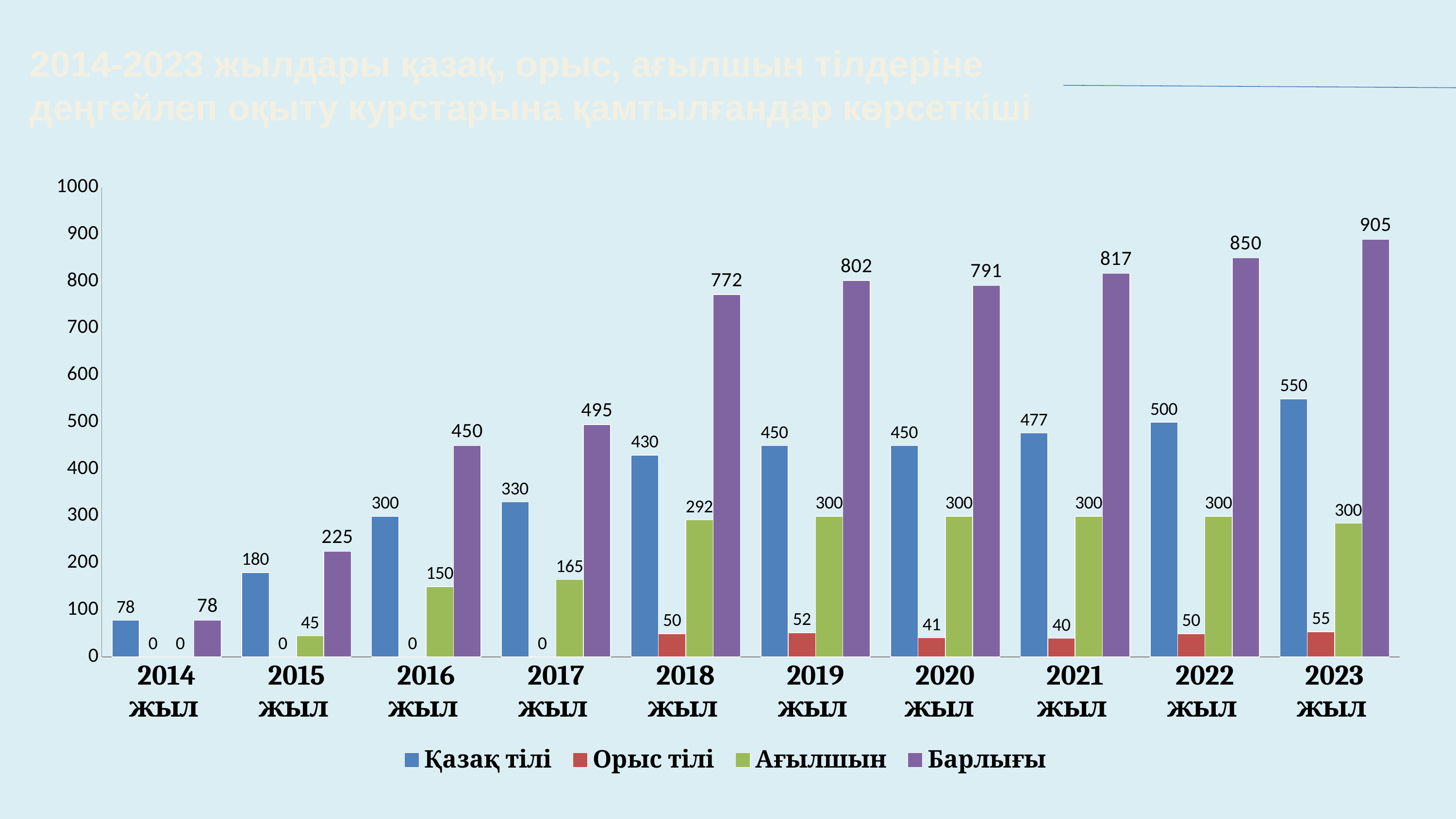
What is the value for Орыс тілі in 2020 жыл? 41 Which is larger, the Барлығы value for 2019 жыл or for 2020 жыл? 2019 жыл What is the difference between the Барлығы values for 2023 жыл and 2022 жыл? 55 How many series does the legend list? 4 How many years are shown on the x axis? 10 In which year is the Қазақ тілі value lowest? 2014 жыл Does the Қазақ тілі value rise or fall from 2014 жыл to 2023 жыл? Rise What is the value for Қазақ тілі in 2023 жыл? 550 In which year is the Барлығы value highest? 2023 жыл What is the value for Барлығы in 2018 жыл? 772 What kind of chart is shown on the slide? Bar chart What is the value for Ағылшын in 2017 жыл? 165